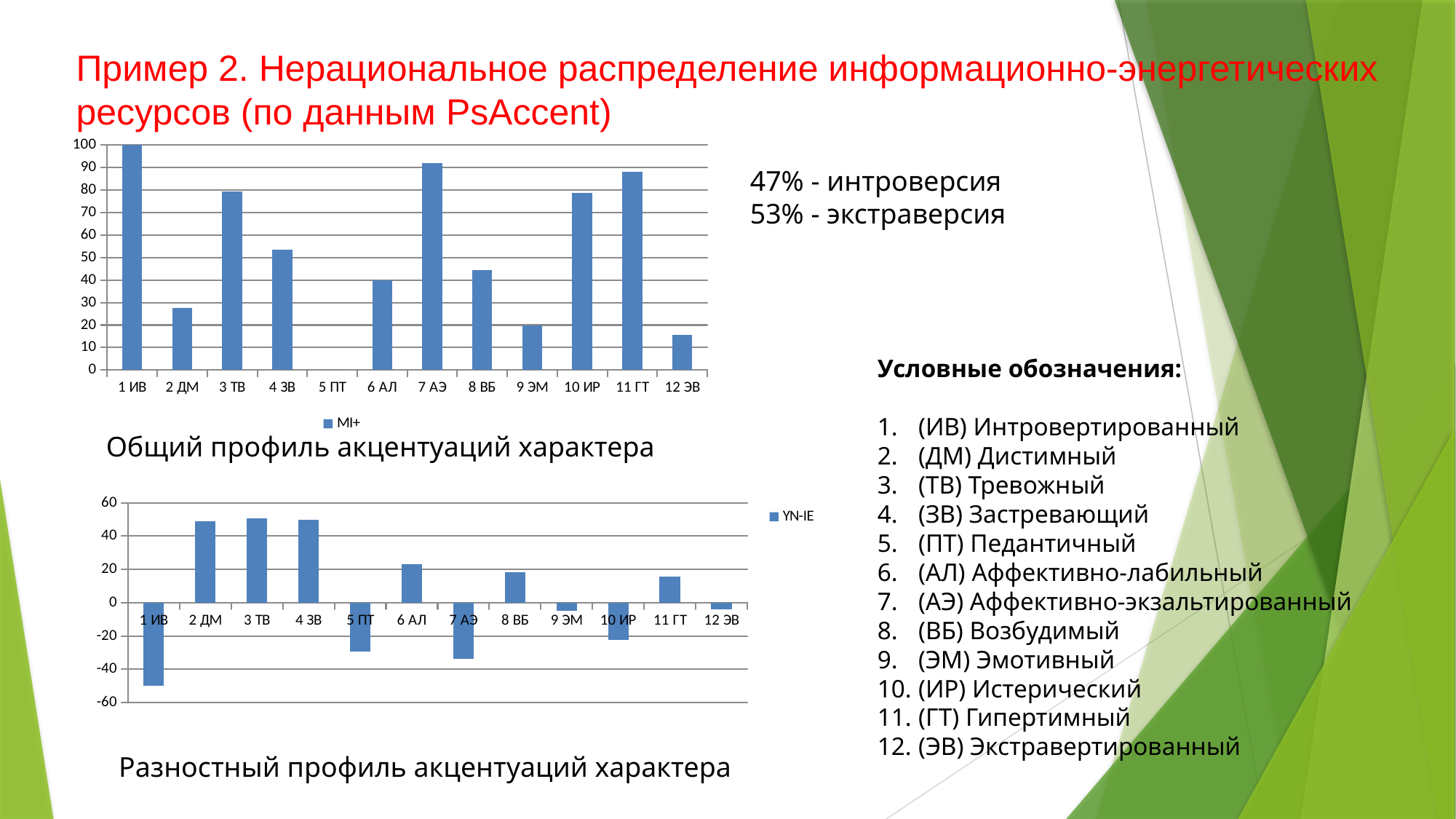
What series name does the legend of the top chart, 'Общий профиль акцентуаций характера', show? MI+ In the top chart, 'Общий профиль акцентуаций характера', what is the value for 1 ИВ? 100 In the bottom chart, 'Разностный профиль акцентуаций характера', which category has the lowest value? 1 ИВ What kind of chart is the top chart, 'Общий профиль акцентуаций характера'? bar chart In the top chart, 'Общий профиль акцентуаций характера', is the value for 7 АЭ greater or less than 90? greater In the bottom chart, 'Разностный профиль акцентуаций характера', is the value for 7 АЭ greater or less than -20? less In the top chart, 'Общий профиль акцентуаций характера', which category has the lowest value? 5 ПТ In the top chart, 'Общий профиль акцентуаций характера', which is larger: the value for 3 ТВ or the value for 4 ЗВ? 3 ТВ In the top chart, 'Общий профиль акцентуаций характера', which category has the highest value? 1 ИВ How many categories are shown on the x axis of the top chart, 'Общий профиль акцентуаций характера'? 12 In the top chart, 'Общий профиль акцентуаций характера', is the value for 2 ДМ greater or less than 30? less In the bottom chart, 'Разностный профиль акцентуаций характера', which is larger: the value for 7 АЭ or the value for 10 ИР? 10 ИР